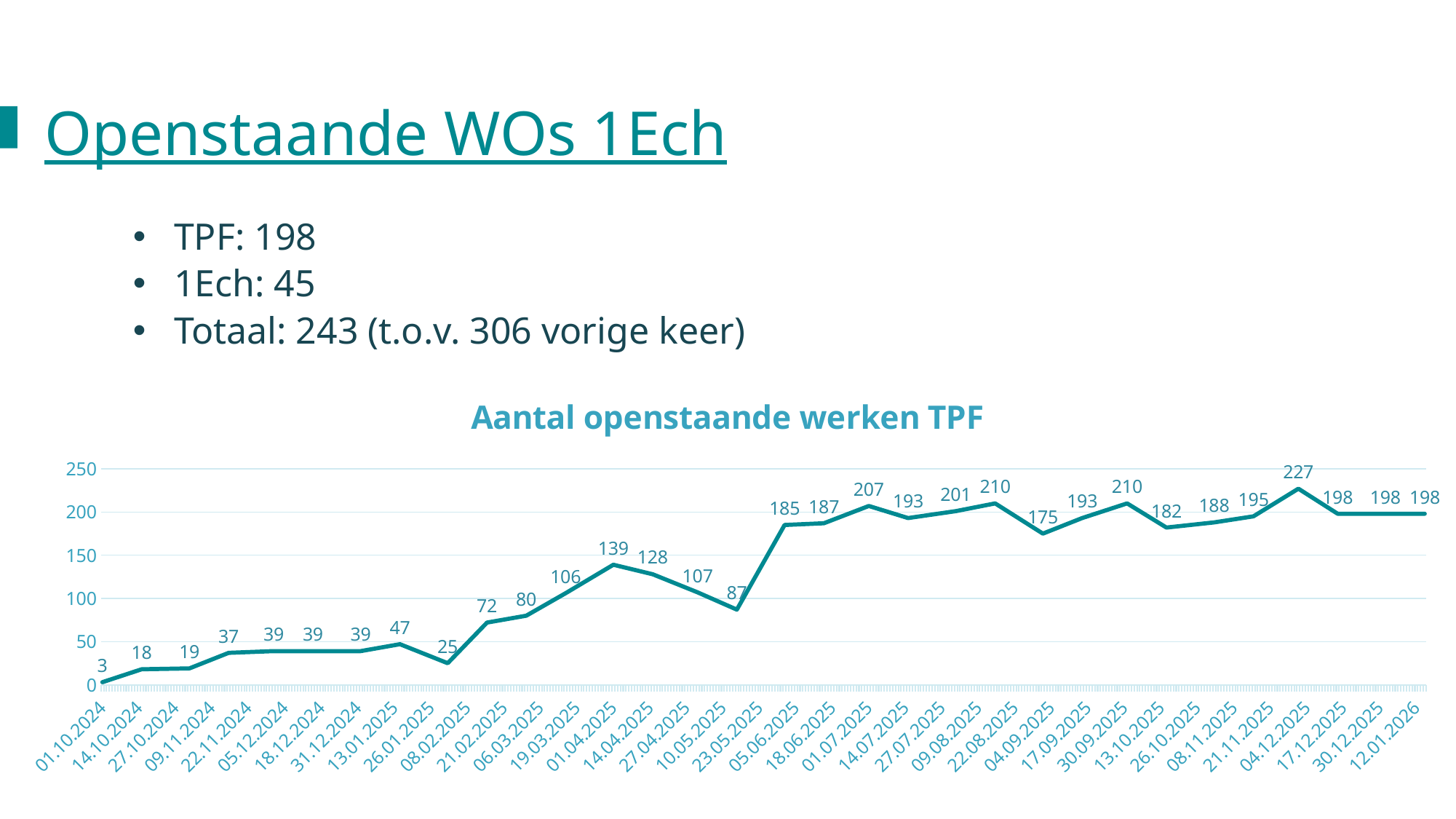
What kind of chart is shown on the slide? line chart Overall, do the values rise or fall from left to right along the x axis? rise What is the difference between the highest value (227) and the lowest value (3) on the line? 224 What is the title of the chart? Aantal openstaande werken TPF What is the value at the first point of the line (01.10.2024)? 3 What is the highest value plotted on the line? 227 Which is larger: the first value on the line or the last value on the line? the last value What is the difference between the last value (198) and the first value (3) on the line? 195 What is the value at the last point of the line (12.01.2026)? 198 What is the highest tick value shown on the y axis? 250 How many of the last three data labels on the line show the value 198? 3 What is the lowest value plotted on the line? 3